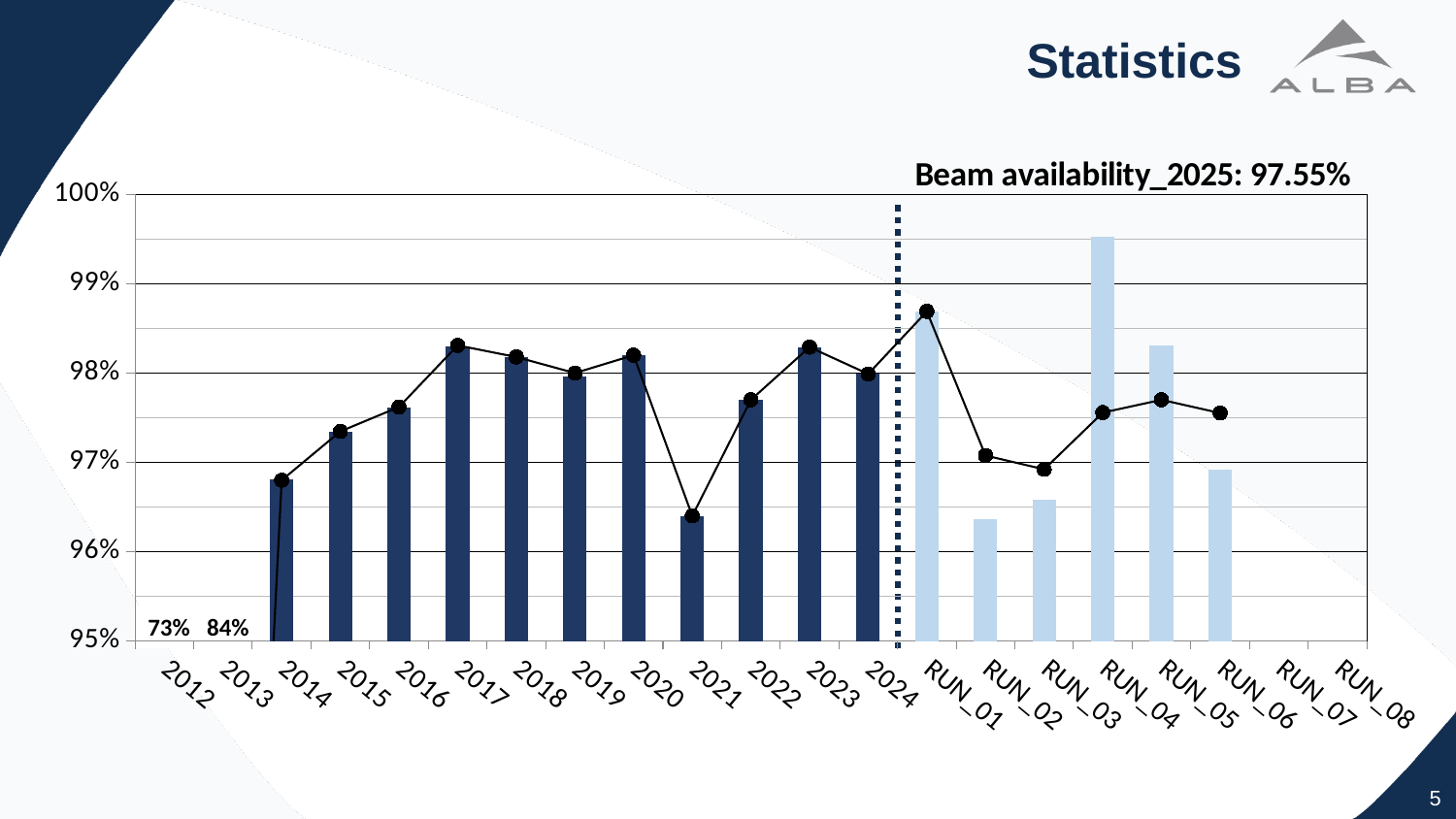
Is the value for 2021 greater or less than 97%? less Is the value for RUN_04 greater or less than 99%? greater Which RUN category has the tallest bar? RUN_04 Which is larger, the value for 2021 or the value for 2022? 2022 Is the value for 2017 greater or less than 98%? greater What is the title of the chart? Beam availability_2025: 97.55% What value is printed for 2012? 73% How many RUN categories are labelled on the x axis? 8 Which is larger, the value for RUN_01 or the value for RUN_02? RUN_01 What value is printed for 2013? 84% Which category has the lowest value on the chart? 2012 What is the difference between the printed values for 2013 and 2012? 11 percentage points